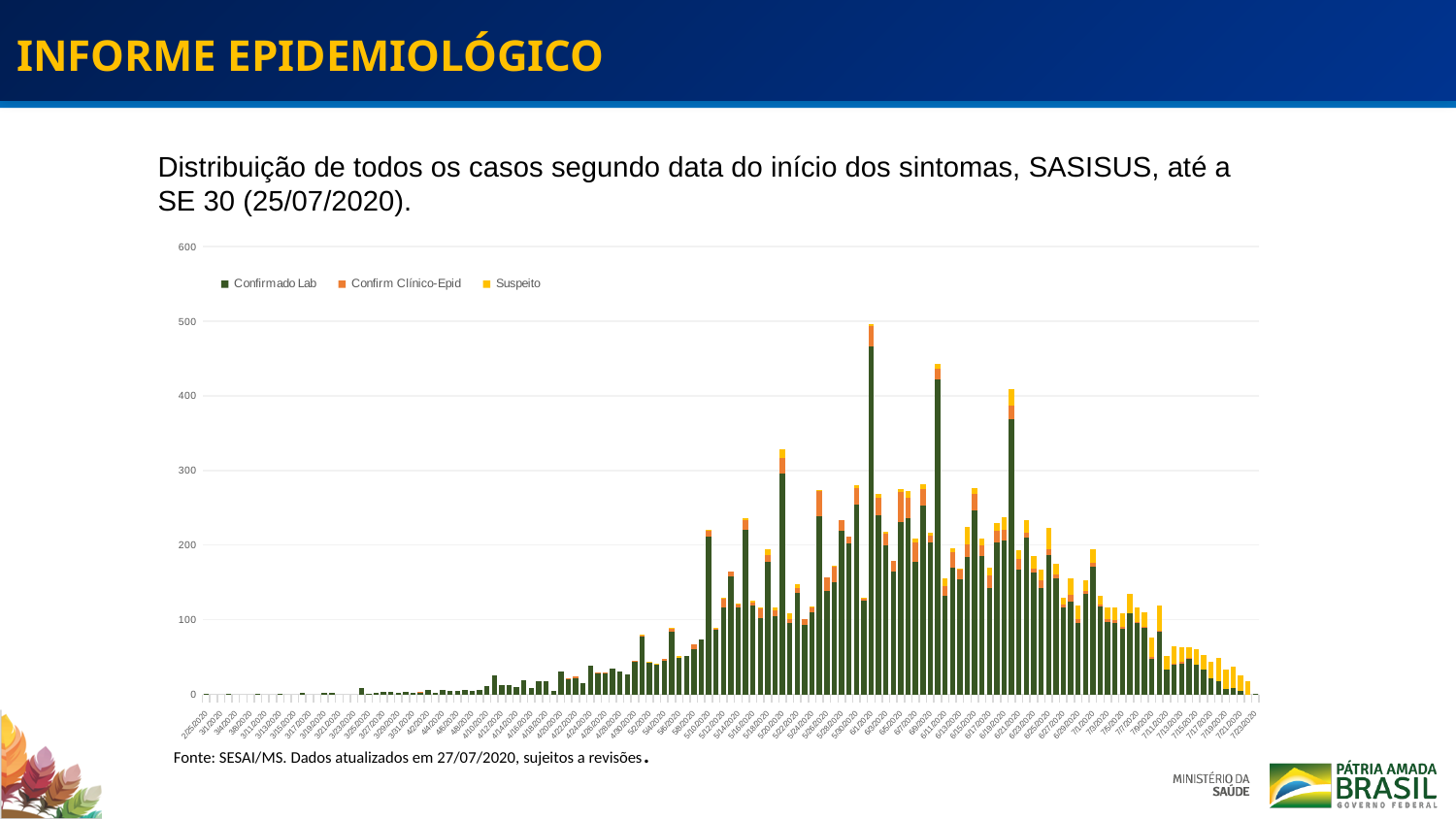
What is the title of the chart? Distribuição de todos os casos segundo data do início dos sintomas, SASISUS, até a SE 30 (25/07/2020). Do the bar heights generally rise or fall from late February to early June? rise How many series does the chart legend list? 3 Which series makes up the largest part of most bars? Confirmado Lab Is the value for the first date on the x axis, 2/25/2020, greater or less than 100? less Is the value of the tallest bar in the chart greater or less than 400? greater Do the bar heights generally rise or fall from mid-June to late July? fall Is the value of the tallest bar greater or less than 300? greater What are the three series named in the chart legend? Confirmado Lab, Confirm Clínico-Epid, Suspeito What kind of chart is shown on the slide? Stacked bar chart